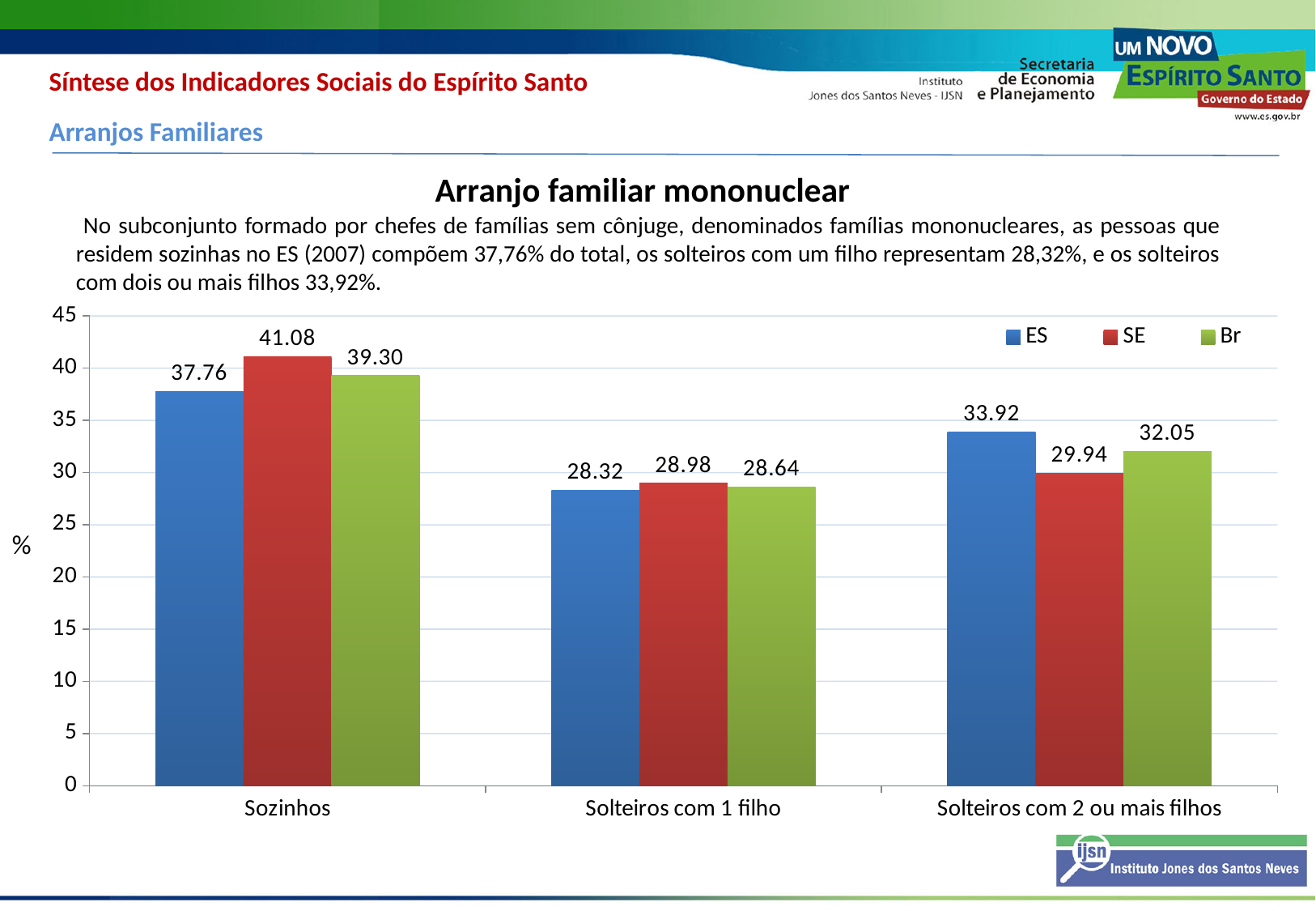
What is the title of the chart? Arranjo familiar mononuclear How many categories are shown on the x axis? 3 Which is larger: the ES value for Solteiros com 2 ou mais filhos or the Br value for Solteiros com 2 ou mais filhos? ES What is the value for ES in the Sozinhos category? 37.76 What kind of chart is shown on the slide? bar chart What is the difference between the SE and ES values in the Sozinhos category? 3.32 What is the value for Br in the Solteiros com 1 filho category? 28.64 What is the value for SE in the Solteiros com 2 ou mais filhos category? 29.94 Which series has the highest value in the Sozinhos category? SE Which series has the lowest value in the Solteiros com 2 ou mais filhos category? SE Is the Br value for Sozinhos greater or less than 35? greater How many series does the legend list? 3